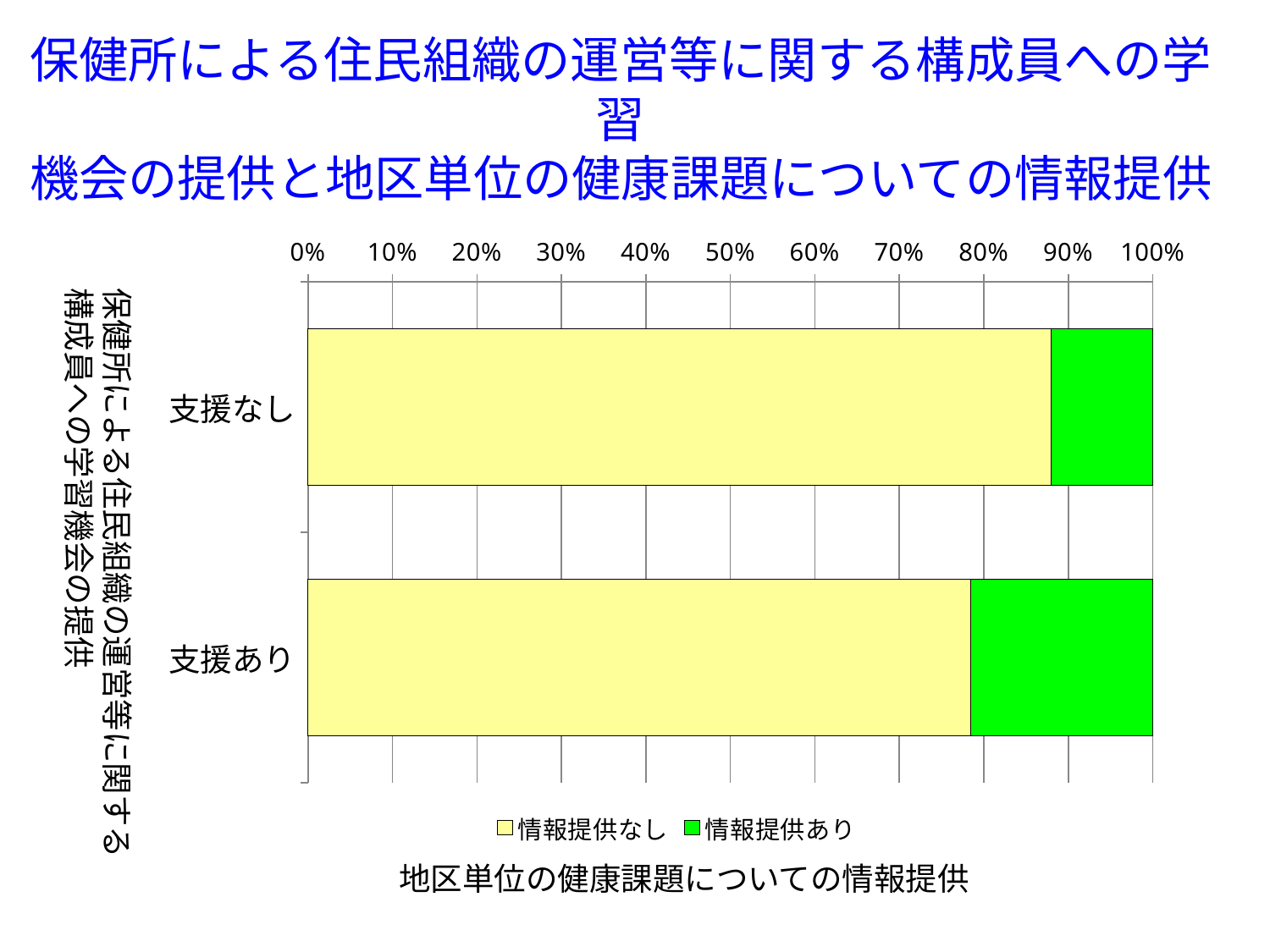
Which category has the larger 情報提供なし share, 支援なし or 支援あり? 支援なし Is the 情報提供なし share for 支援あり greater or less than 90%? less Which category has the larger 情報提供あり share, 支援なし or 支援あり? 支援あり What are the two series listed in the chart legend? 情報提供なし, 情報提供あり How many categories are shown on the vertical axis of the chart? 2 Is the 情報提供なし share for 支援なし greater or less than 80%? greater What kind of chart is shown on the slide? stacked bar chart What is the total of the stacked bar for 支援あり? 100% Is the 情報提供あり share for 支援なし greater or less than 20%? less How many series does the chart legend list? 2 What is the title of the horizontal axis of the chart? 地区単位の健康課題についての情報提供